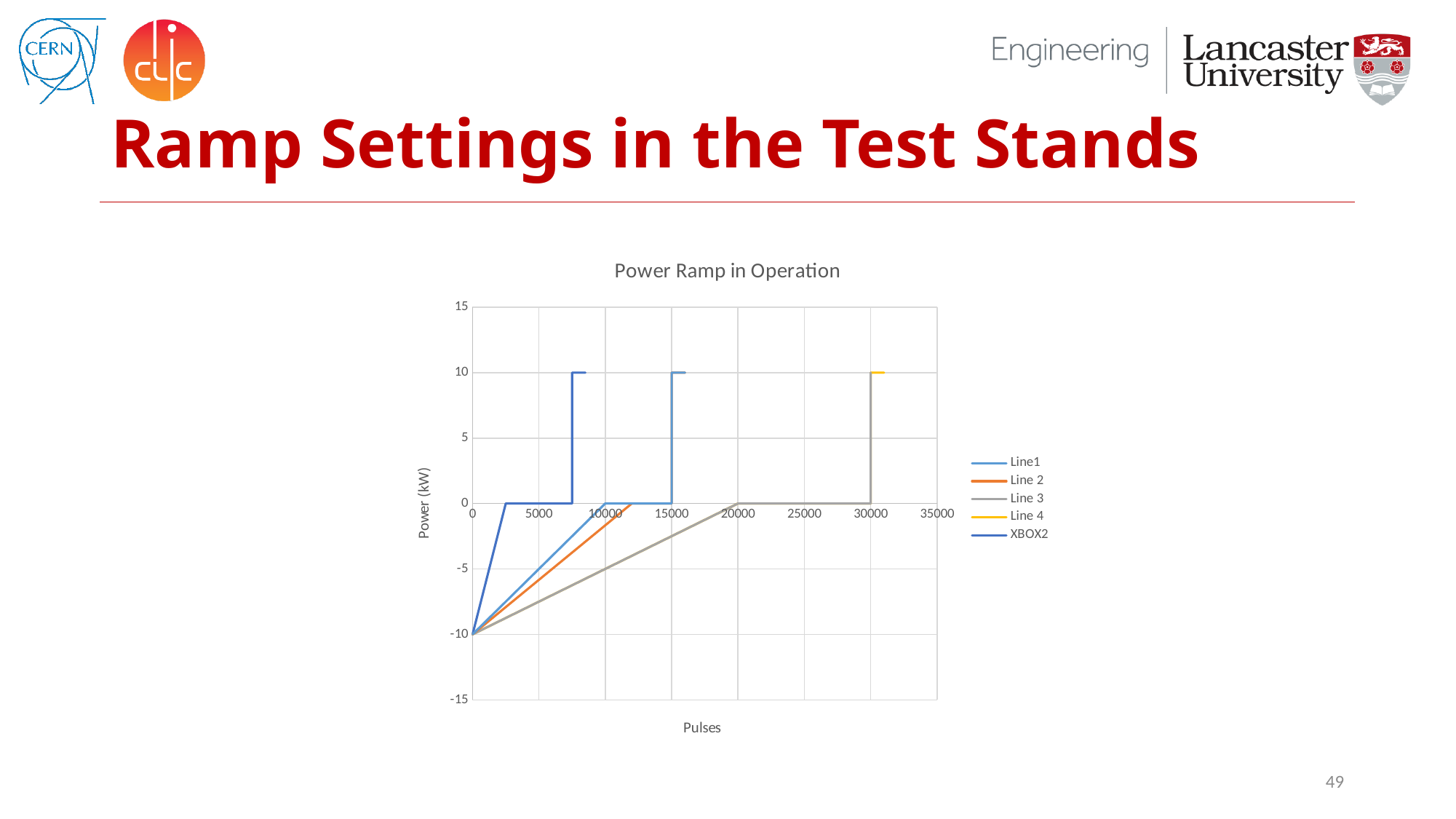
Does the value of Line 3 rise or fall as pulses increase from 0 to 20000? rise Is the value of XBOX2 at 5000 pulses greater or less than -5? greater What is the label of the vertical axis of the chart? Power (kW) What is the title of the chart? Power Ramp in Operation What kind of chart is shown on the slide? line chart How many series does the chart legend list? 5 Is the value of Line 3 at 5000 pulses greater or less than -5? less Is the value of XBOX2 at 10000 pulses greater or less than 5? greater At 5000 pulses, which series has the higher value, XBOX2 or Line 3? XBOX2 What is the highest value shown on the Power (kW) axis? 15